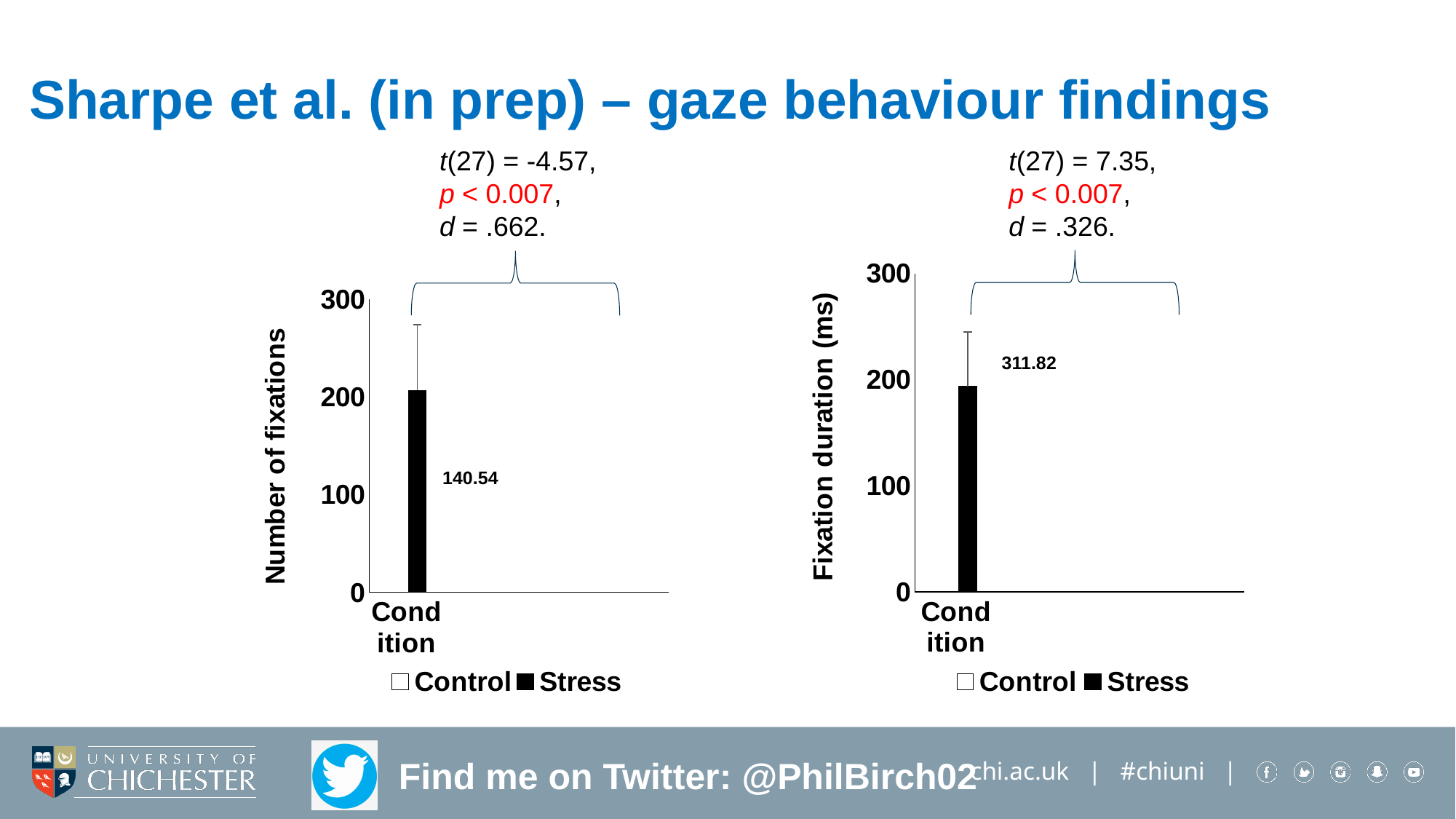
In the left chart (Number of fixations), is the value of the black Stress bar greater or less than 300? less What is the y-axis title of the left chart? Number of fixations How many series does the legend of the left chart (Number of fixations) list? 2 What kind of chart is the right chart (Fixation duration (ms))? bar chart How many series does the legend of the right chart (Fixation duration (ms)) list? 2 What numeric data label is printed inside the plot area of the left chart (Number of fixations)? 140.54 What are the two legend entries of the right chart (Fixation duration (ms))? Control and Stress In the left chart (Number of fixations), is the value of the black Stress bar greater or less than 100? greater In the right chart (Fixation duration (ms)), is the value of the black Stress bar greater or less than 100? greater What kind of chart is the left chart (Number of fixations)? bar chart What numeric data label is printed inside the plot area of the right chart (Fixation duration (ms))? 311.82